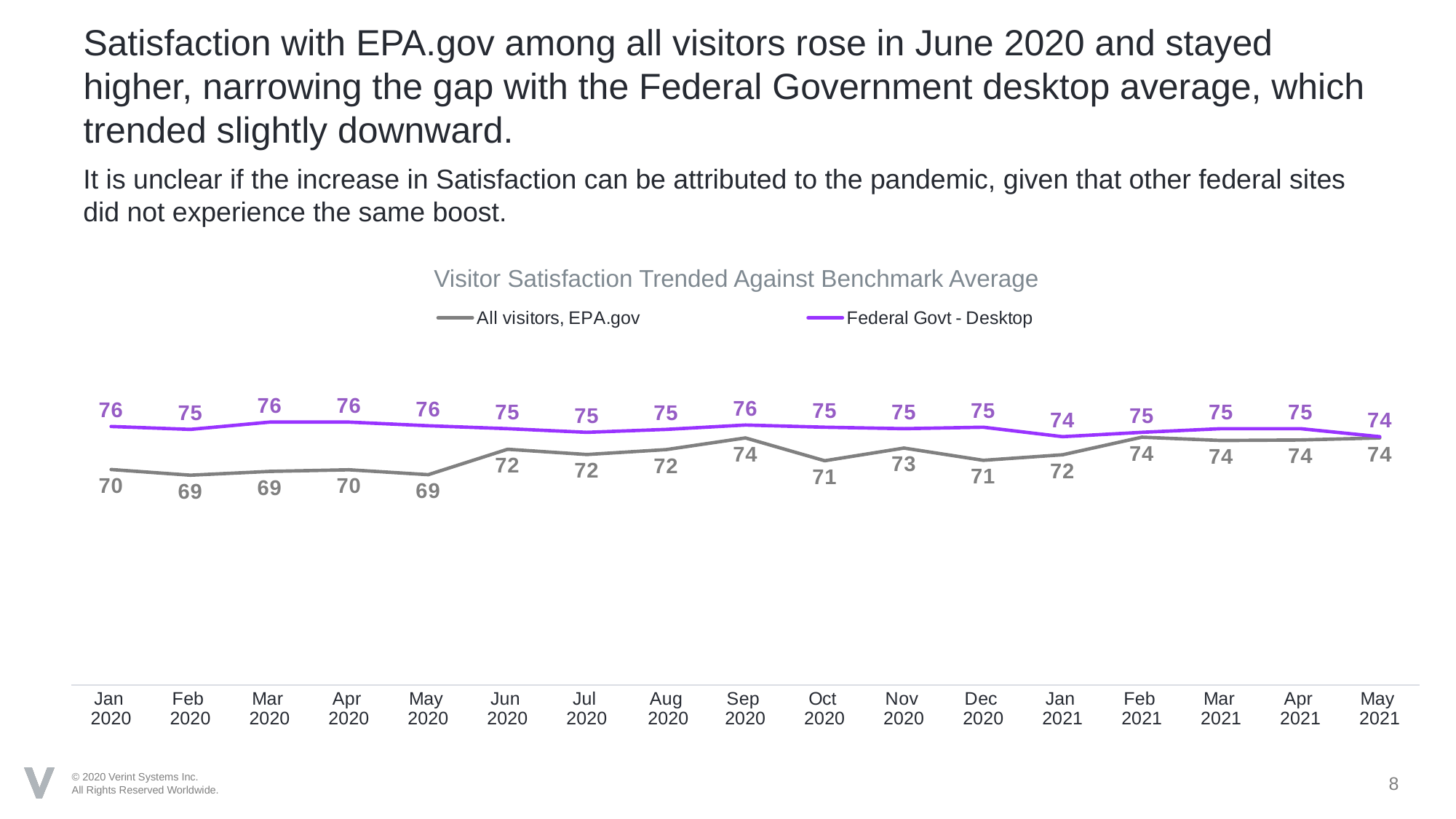
What kind of chart is shown on the slide? Line chart What is the value for Federal Govt - Desktop in Sep 2020? 76 What is the value for All visitors, EPA.gov in Oct 2020? 71 What is the difference between Federal Govt - Desktop and All visitors, EPA.gov in Jan 2020? 6 What is the value for Federal Govt - Desktop in Jan 2021? 74 What is the value for All visitors, EPA.gov in Jan 2020? 70 How many months are plotted on the x axis? 17 What is the lowest value plotted for the Federal Govt - Desktop series? 74 Does the All visitors, EPA.gov series rise or fall from Jan 2020 to May 2021? Rise In Feb 2020, which series has the higher value, All visitors, EPA.gov or Federal Govt - Desktop? Federal Govt - Desktop What is the difference between Federal Govt - Desktop and All visitors, EPA.gov in May 2021? 0 How many series does the legend list? 2